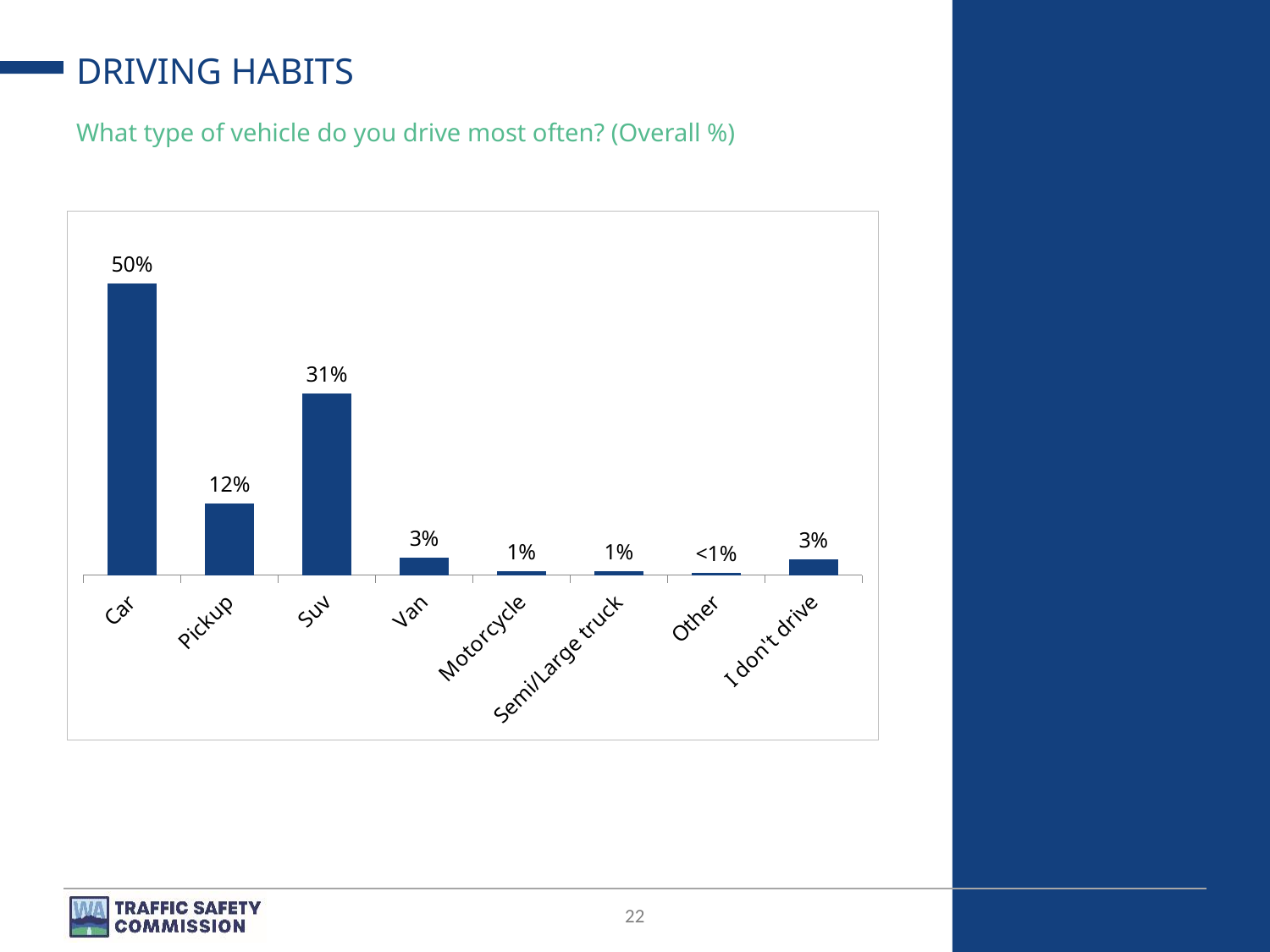
How many categories are shown on the x axis? 8 What percentage of respondents drive a car most often? 50% What question does the chart subtitle say respondents were asked? What type of vehicle do you drive most often? (Overall %) What is the value for Pickup? 12% What is the difference between the values for Car and Suv? 19% Which is larger, the value for Van or the value for Motorcycle? Van What is the value for I don't drive? 3% Which vehicle type has the highest value? Car What kind of chart is shown on the slide? Bar chart What is the value shown for Other? <1% What is the difference between the values for Suv and Pickup? 19% What is the value for Suv? 31%